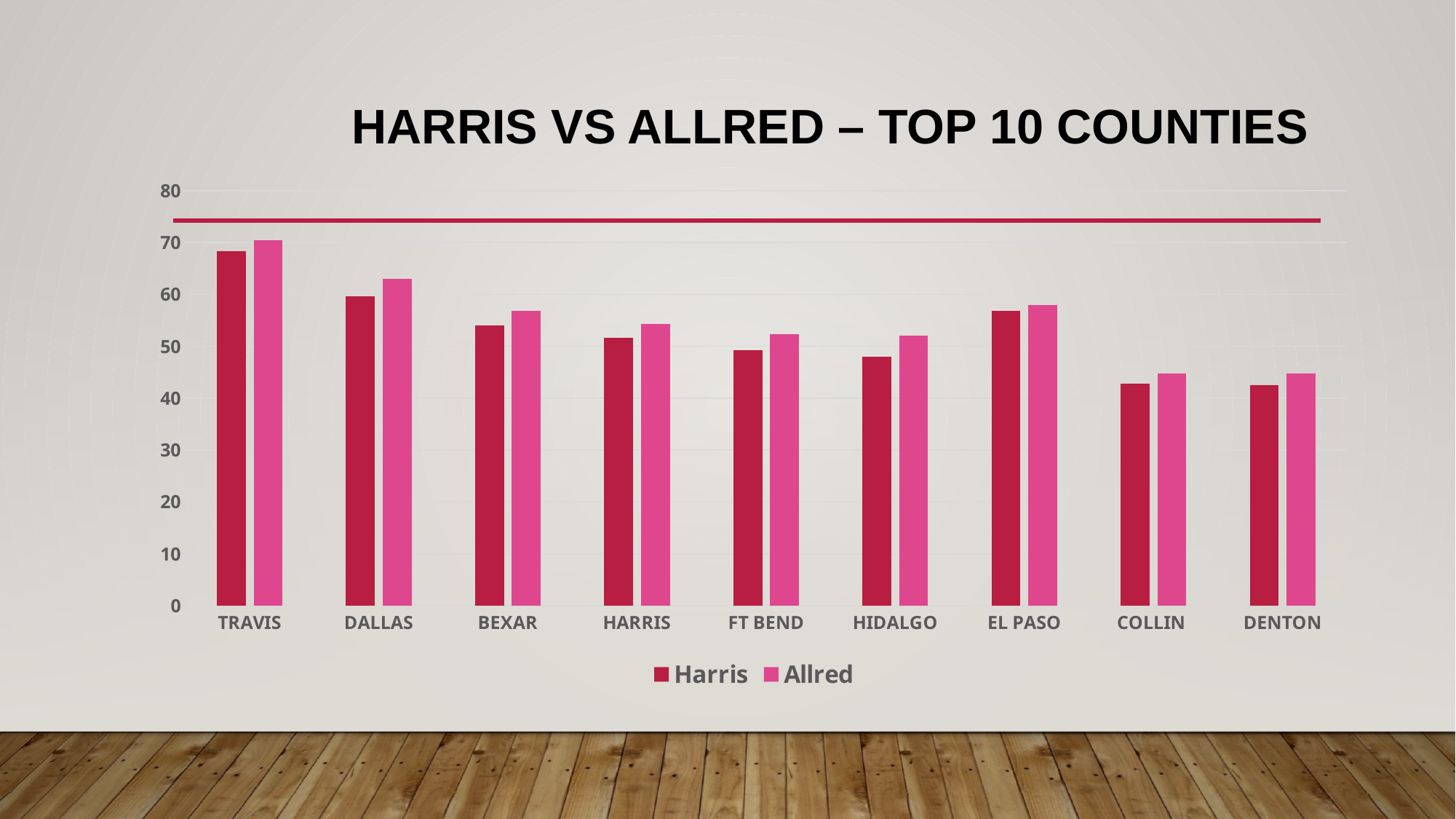
Is the Allred value for Dallas greater or less than 60? greater What kind of chart is shown on the slide? bar chart How many counties are shown on the x axis? 9 Which is larger, the Allred value for Hidalgo or the Allred value for Collin? Hidalgo Is the Allred value for Collin greater or less than 50? less Which is larger, the Harris value for Dallas or the Harris value for Bexar? Dallas What are the two series named in the legend? Harris and Allred Which county has the highest value for Harris? Travis Is the Harris value for Travis greater or less than 60? greater Which county has the highest value for Allred? Travis How many series does the legend list? 2